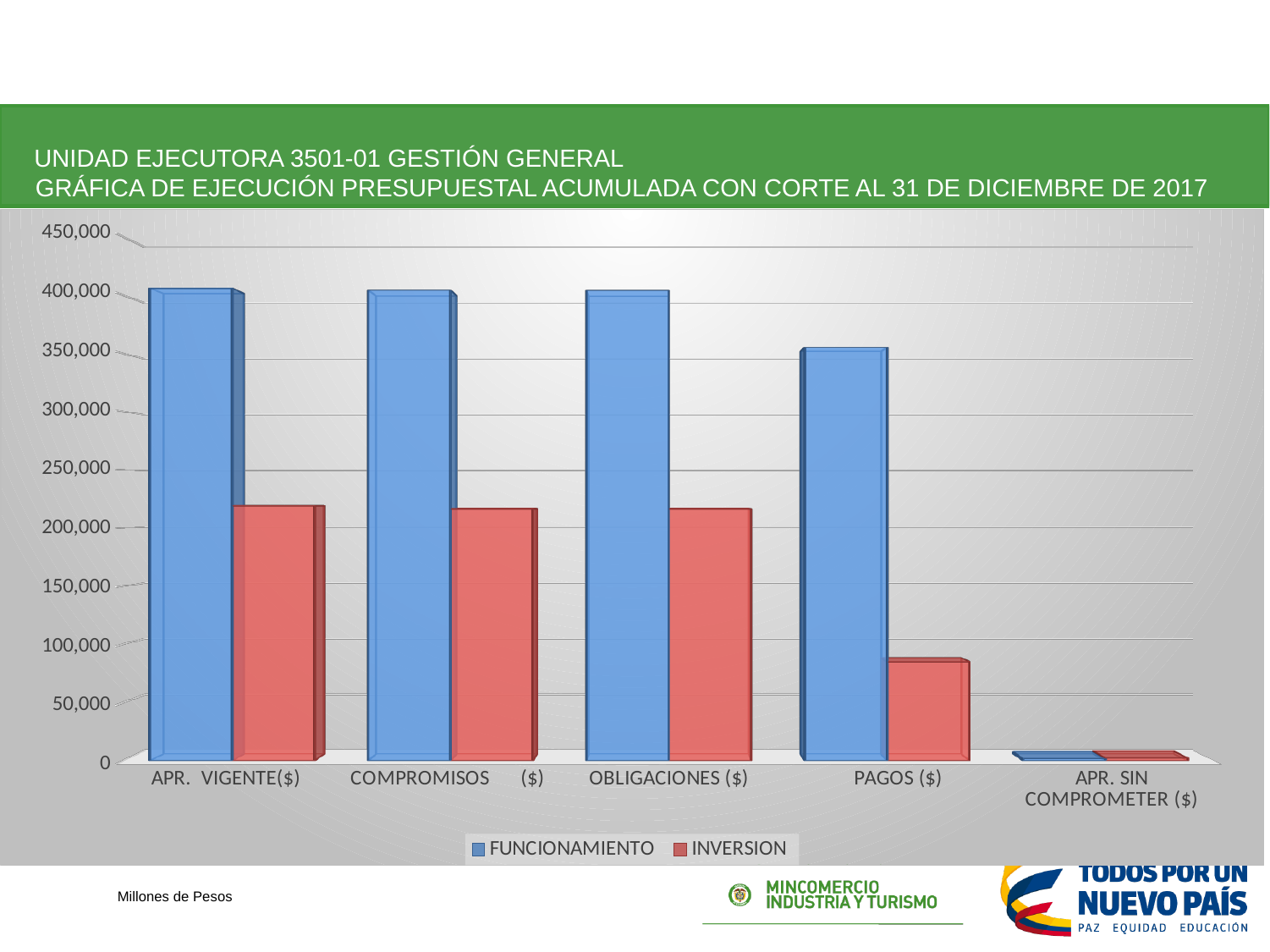
Which category has the lowest INVERSION value? APR. SIN COMPROMETER ($) Do the INVERSION values rise or fall from OBLIGACIONES ($) to PAGOS ($)? fall Which category has the lowest FUNCIONAMIENTO value? APR. SIN COMPROMETER ($) How many categories are shown on the x axis of the chart? 5 Is the INVERSION value for APR. VIGENTE($) greater or less than 250,000? less How many series does the legend list? 2 Is the FUNCIONAMIENTO value for APR. VIGENTE($) greater or less than 350,000? greater Is the INVERSION value for PAGOS ($) greater or less than 100,000? less For PAGOS ($), which series has the larger value, FUNCIONAMIENTO or INVERSION? FUNCIONAMIENTO What kind of chart is shown on the slide? Bar chart Which colour represents the FUNCIONAMIENTO series in the legend? Blue